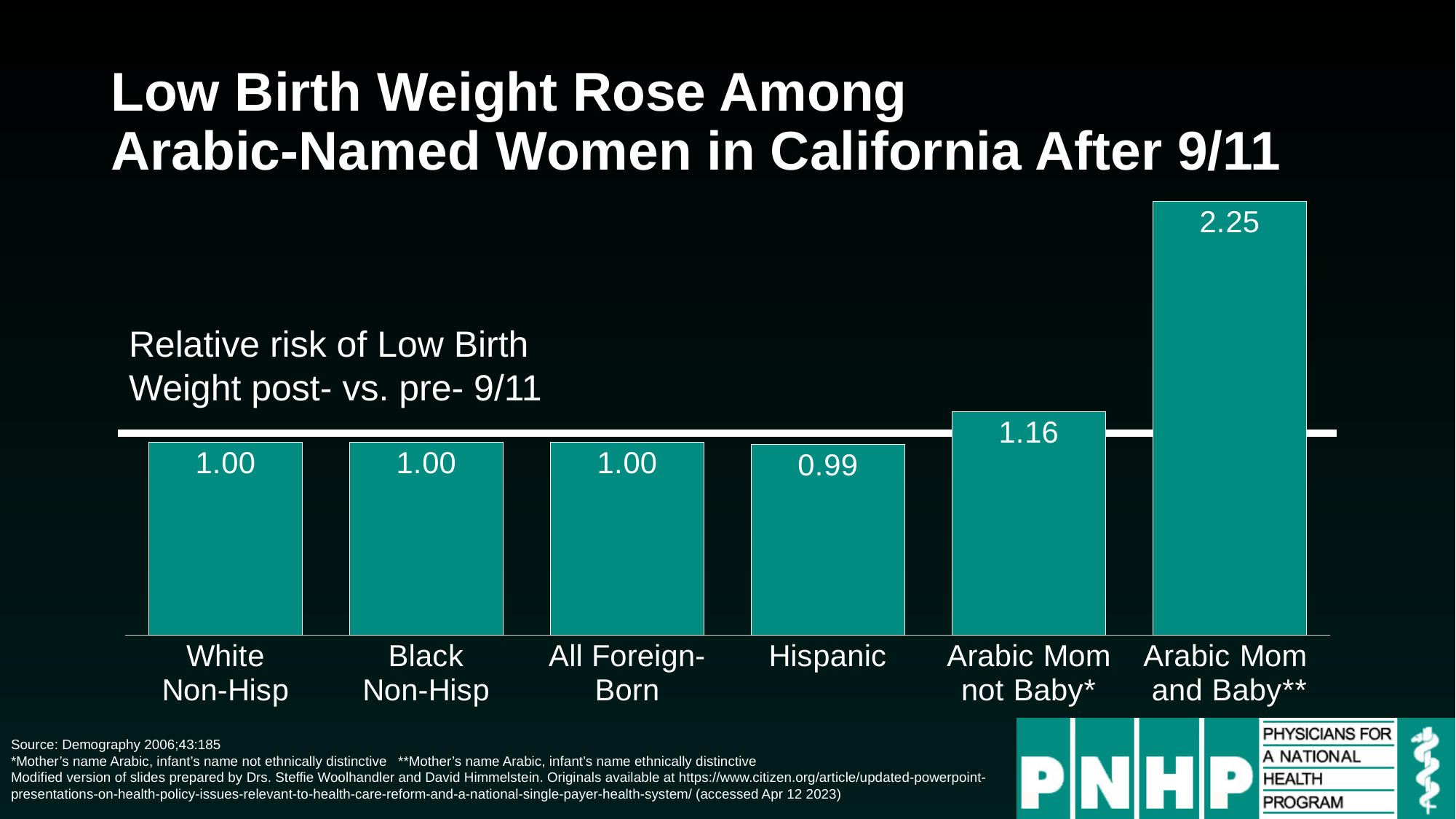
What kind of chart is shown on the slide? Bar chart What is the relative risk of low birth weight for Arabic Mom and Baby**? 2.25 Which category has the highest relative risk of low birth weight? Arabic Mom and Baby** What is the relative risk of low birth weight for White Non-Hisp? 1.00 How many categories are shown in the chart? 6 What is the difference in relative risk between Arabic Mom and Baby** and Arabic Mom not Baby*? 1.09 What is the relative risk of low birth weight for Arabic Mom not Baby*? 1.16 What is the difference in relative risk between Arabic Mom not Baby* and Black Non-Hisp? 0.16 Which has a larger relative risk, Arabic Mom not Baby* or All Foreign-Born? Arabic Mom not Baby* What is the title of the slide containing the chart? Low Birth Weight Rose Among Arabic-Named Women in California After 9/11 Which category has the lowest relative risk of low birth weight? Hispanic What is the relative risk of low birth weight for Hispanic? 0.99